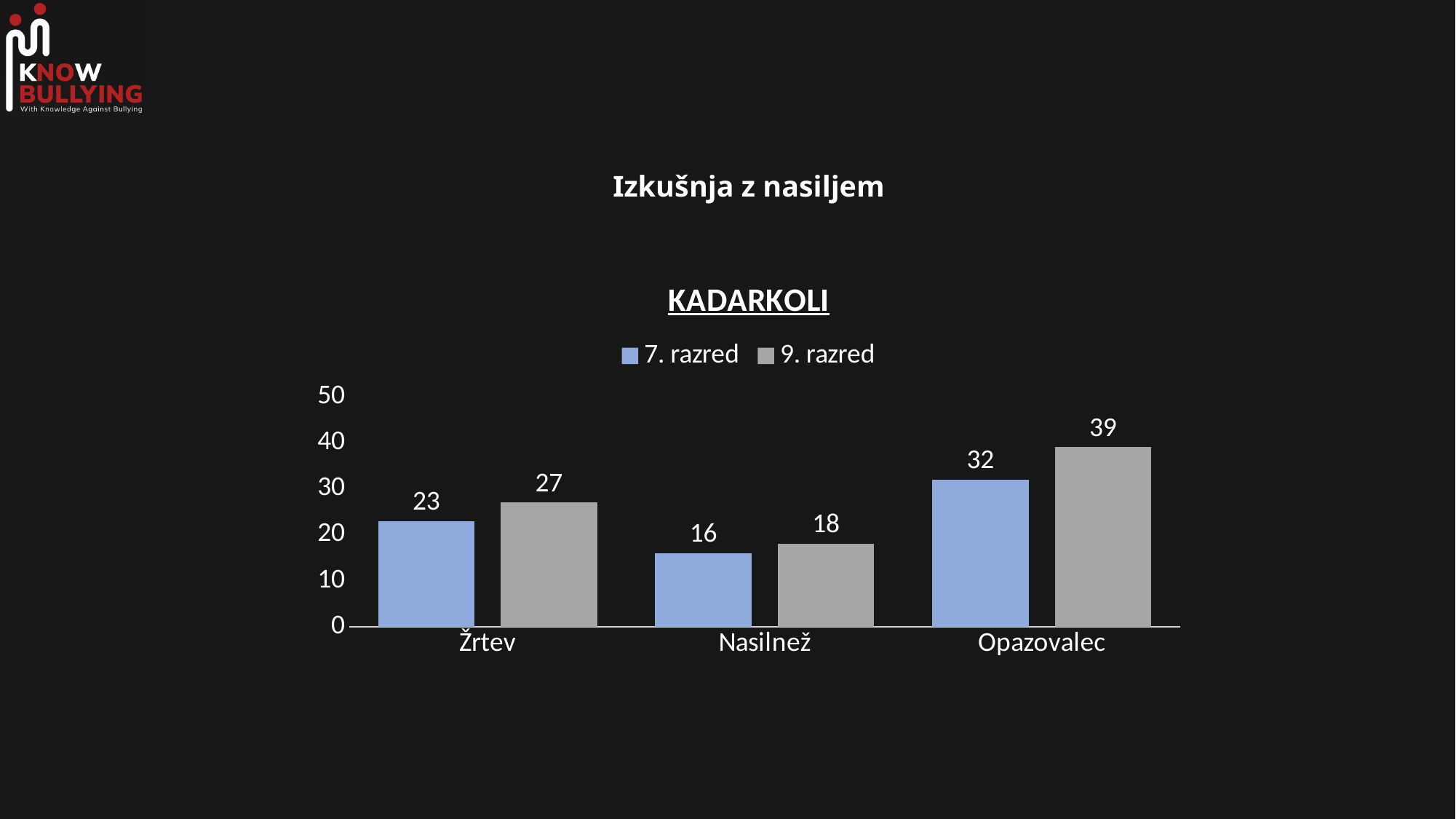
What is the difference between the 9. razred and 7. razred values for Žrtev? 4 What is the difference between the 9. razred and 7. razred values for Opazovalec? 7 Which category has the highest value for 9. razred? Opazovalec What is the value for 9. razred in the Opazovalec category? 39 Which is larger for Nasilnež: the 7. razred value or the 9. razred value? 9. razred Which category has the lowest value for 7. razred? Nasilnež How many series does the legend list? 2 What is the title of the chart? KADARKOLI What is the value for 7. razred in the Žrtev category? 23 What is the value for 9. razred in the Nasilnež category? 18 How many categories are shown on the x axis? 3 What kind of chart is shown on the slide? Bar chart